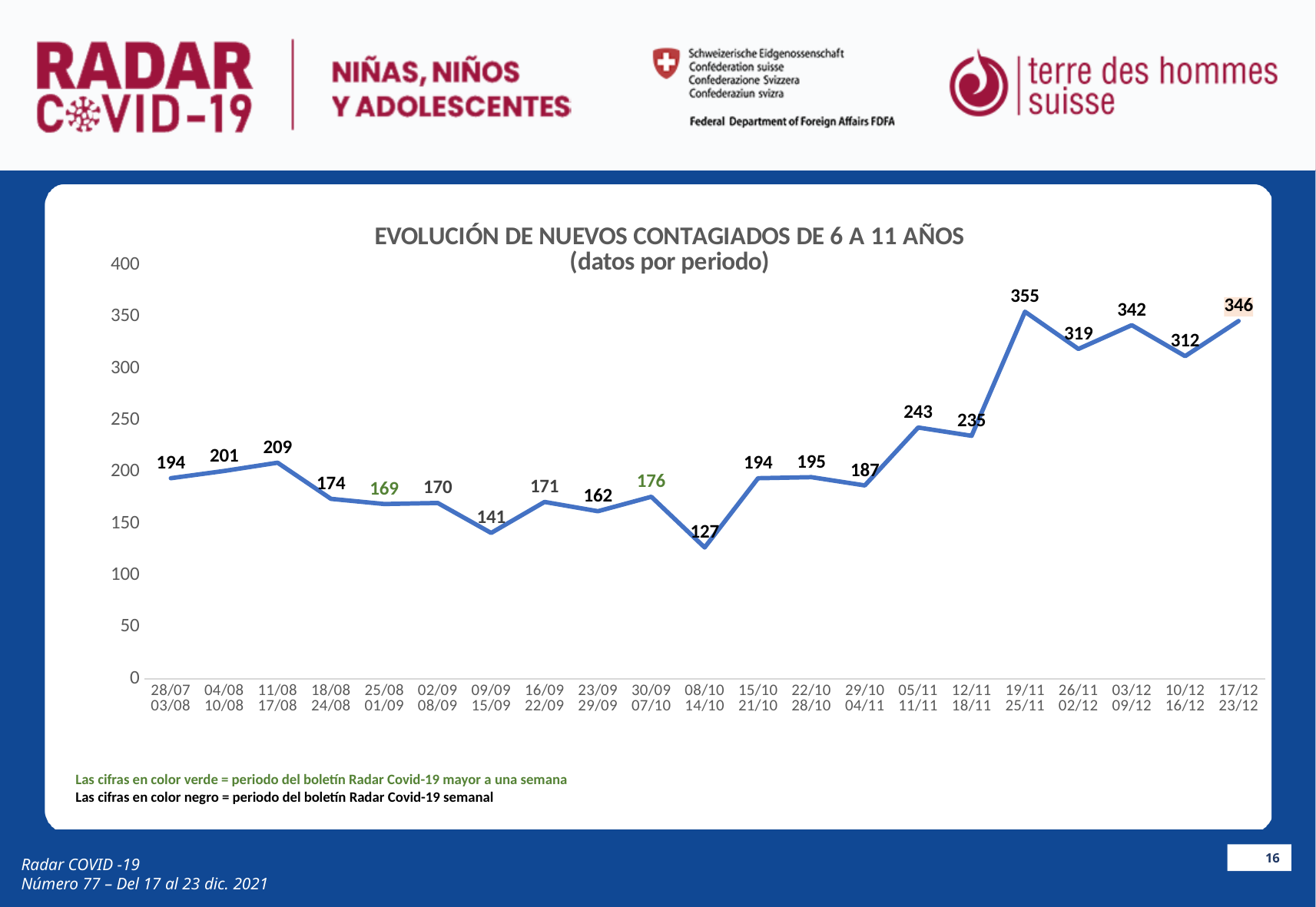
Do the values generally rise or fall from 29/10–04/11 to 19/11–25/11? Rise What is the value for the period 25/08–01/09? 169 What is the difference between the values for 19/11–25/11 and 26/11–02/12? 36 How many periods (data points) are plotted on the chart? 21 What is the value for the period 17/12–23/12? 346 What is the value for the period 08/10–14/10? 127 According to the note below the chart, what do the green figures indicate? Periodo del boletín Radar Covid-19 mayor a una semana What is the value for the period 19/11–25/11? 355 Which is larger, the value for 03/12–09/12 or the value for 10/12–16/12? 03/12–09/12 Which period has the highest value? 19/11–25/11 Which period has the lowest value? 08/10–14/10 What kind of chart is shown on the slide? Line chart